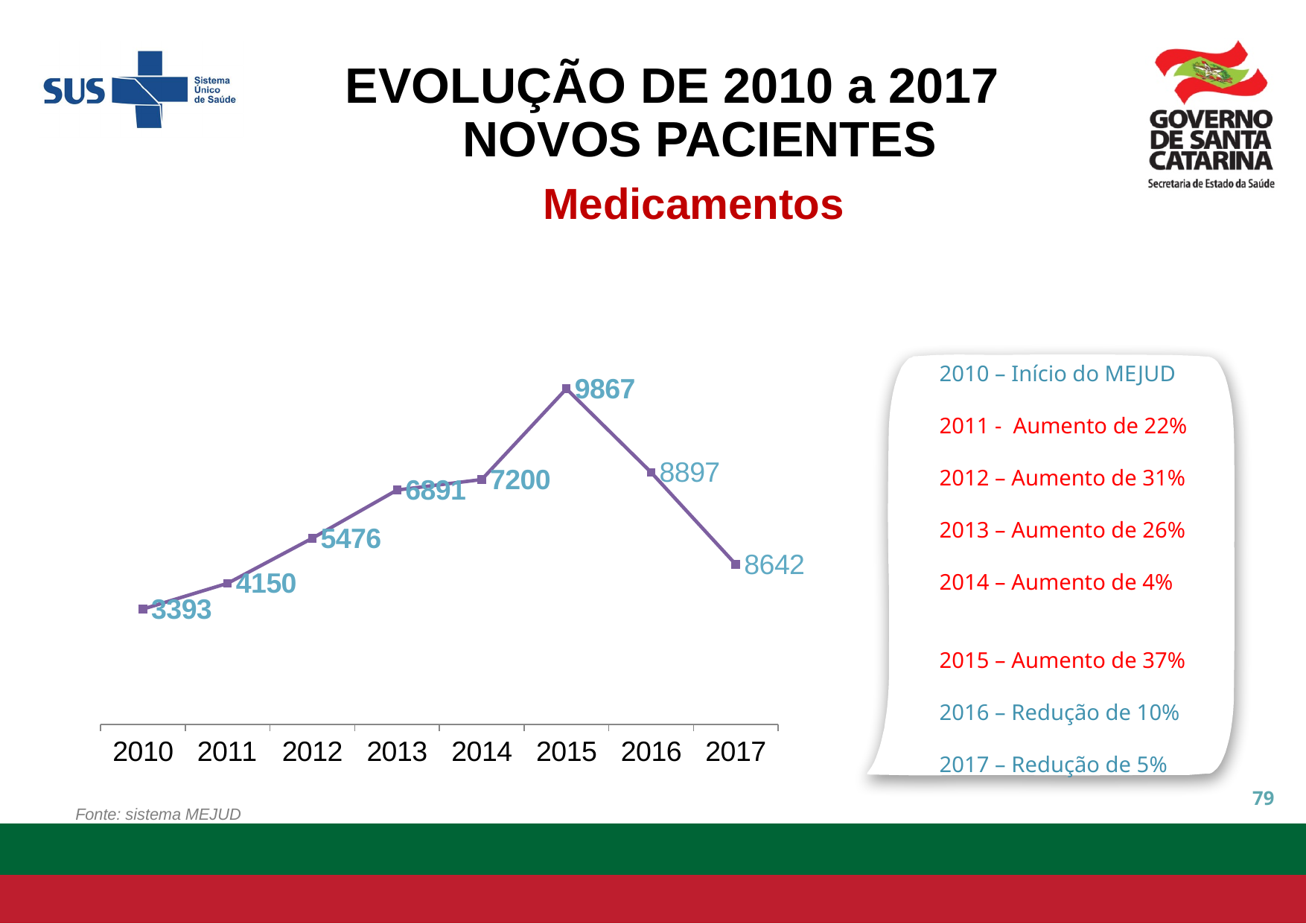
Do the values rise or fall from 2010 to 2015? Rise Which year has the highest value? 2015 How many years are plotted on the x axis? 8 What is the value for 2017? 8642 What is the value for 2016? 8897 What kind of chart is shown on the slide? Line chart What is the value for 2013? 6891 What is the difference between the values for 2015 and 2014? 2667 Which is larger, the value for 2016 or the value for 2017? 2016 Which year has the lowest value? 2010 What is the difference between the values for 2012 and 2011? 1326 What is the value for 2010? 3393